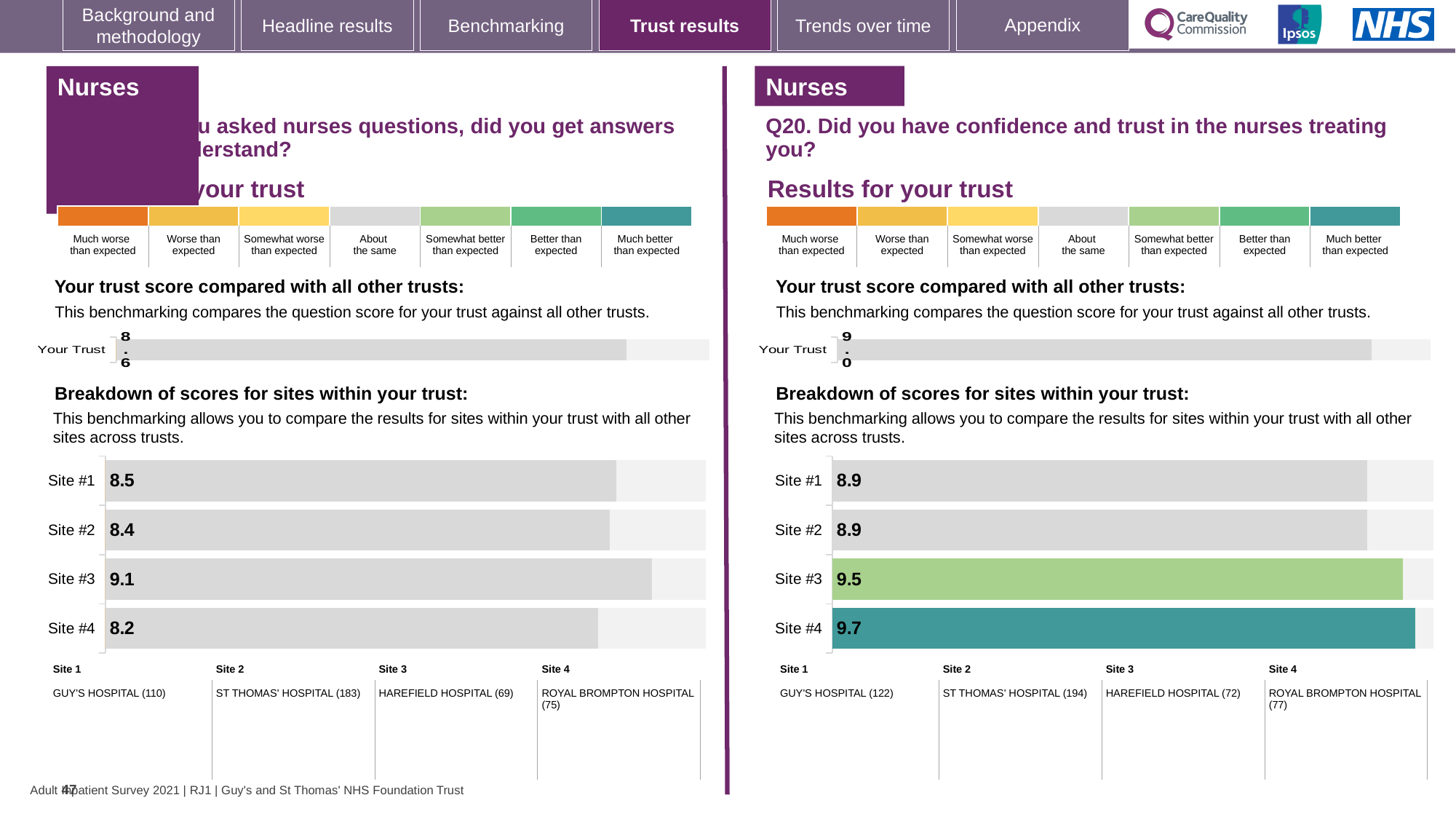
What type of chart is used for the site breakdown on the right-hand (Q20) side? Bar chart On the right-hand (Q20) site breakdown chart, what is the score for Site #4? 9.7 On the right-hand (Q20) site breakdown chart, what is the difference between the scores for Site #4 and Site #1? 0.8 On the right-hand (Q20) site breakdown chart, which is larger: the score for Site #3 or Site #2? Site #3 On the right-hand (Q20) site breakdown chart, which site's bar is coloured teal (the 'Much better than expected' colour)? Site #4 On the left-hand site breakdown chart, which site has the lowest score? Site #4 On the left-hand 'Your Trust' chart, what is the trust score? 8.6 On the right-hand (Q20) 'Your Trust' chart, what is the trust score? 9.0 On the left-hand site breakdown chart, what is the difference between the scores for Site #3 and Site #4? 0.9 On the right-hand (Q20) site breakdown chart, which site has the highest score? Site #4 How many sites are shown in the left-hand site breakdown chart? 4 On the left-hand site breakdown chart, what is the score for Site #3? 9.1